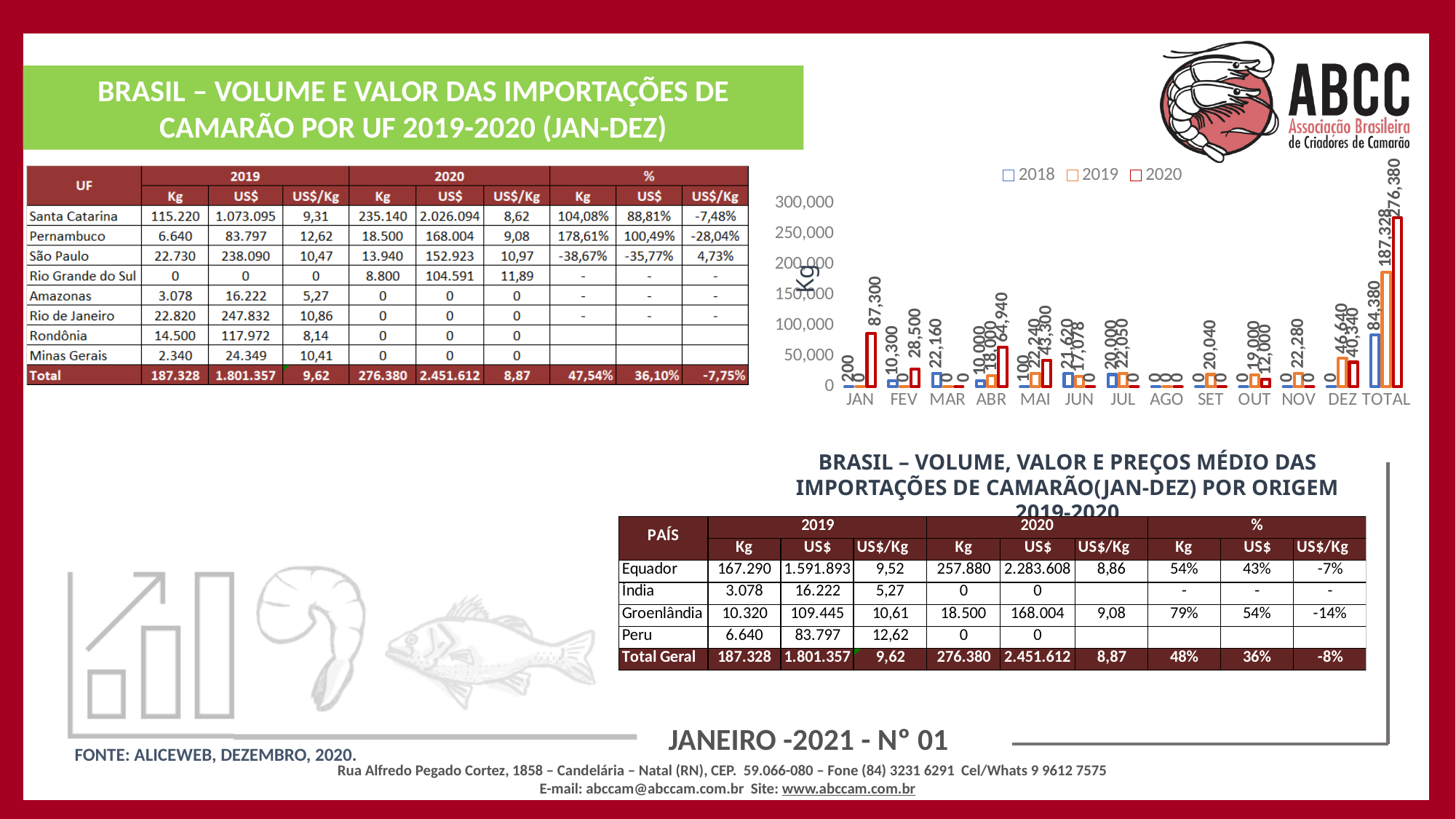
What is the 2019 value for TOTAL in the chart? 187,328 What is the 2020 value for JAN in the chart? 87,300 How many series does the chart's legend list? 3 What is the difference between the 2020 and 2019 values for TOTAL? 89,052 Which series does the chart's legend list? 2018, 2019, 2020 What kind of chart is shown on the slide? bar chart Is the 2018 value for TOTAL greater or less than 100,000? less How many categories are shown along the x axis of the chart? 13 What is the 2020 value for FEV in the chart? 28,500 What is the 2020 value for TOTAL in the chart? 276,380 Among the months JAN to DEZ, which has the highest 2020 value? JAN For DEZ, which is larger: the 2019 value or the 2020 value? 2019